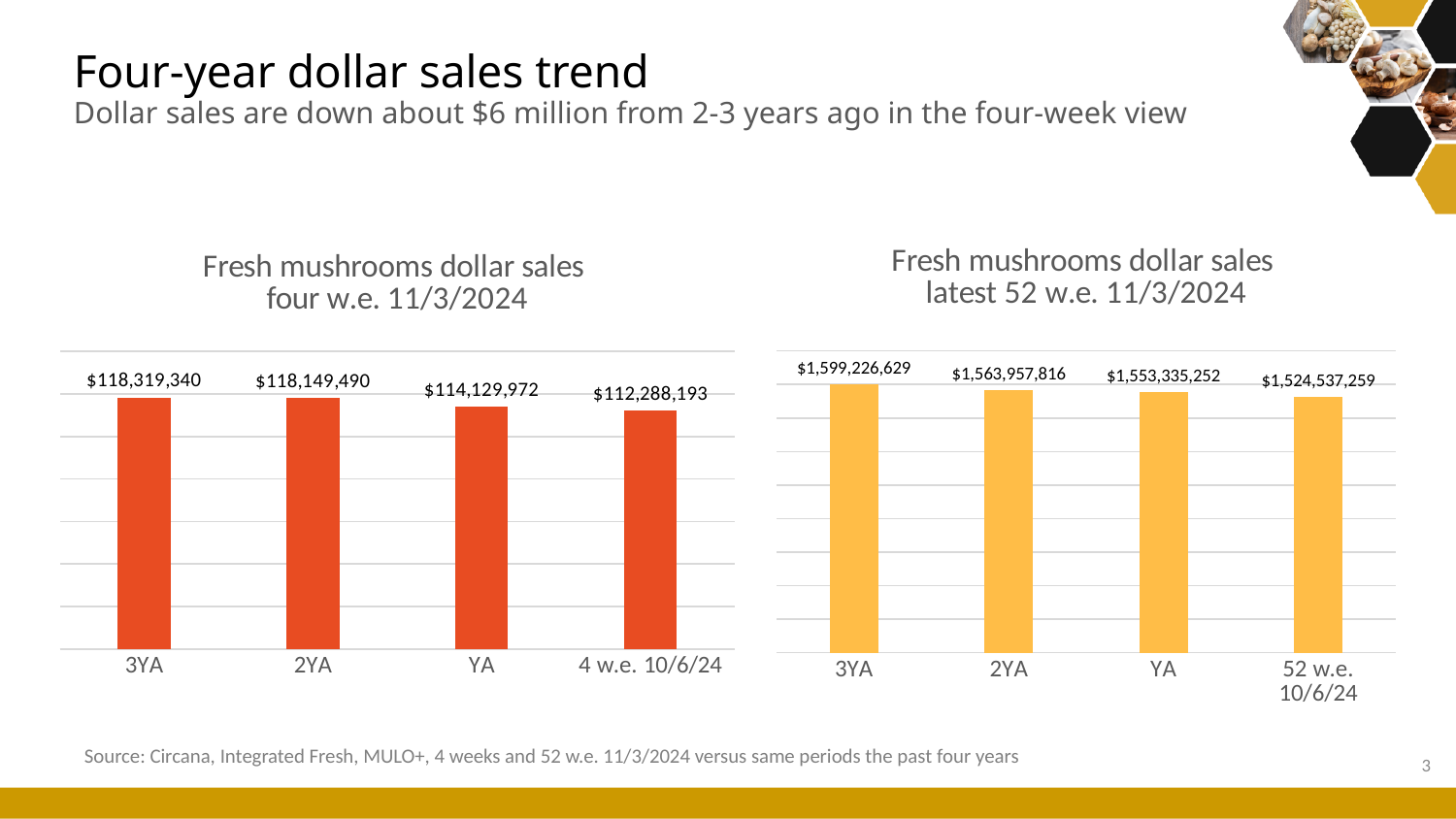
In the 'Fresh mushrooms dollar sales four w.e. 11/3/2024' chart, which category has the lowest value? 4 w.e. 10/6/24 How many categories are shown in the 'Fresh mushrooms dollar sales latest 52 w.e. 11/3/2024' chart? 4 In the 'Fresh mushrooms dollar sales four w.e. 11/3/2024' chart, which is larger, the value for YA or the value for 4 w.e. 10/6/24? YA In the 'Fresh mushrooms dollar sales four w.e. 11/3/2024' chart, what is the value for 3YA? $118,319,340 In the 'Fresh mushrooms dollar sales latest 52 w.e. 11/3/2024' chart, what is the value for 52 w.e. 10/6/24? $1,524,537,259 In the 'Fresh mushrooms dollar sales latest 52 w.e. 11/3/2024' chart, what is the value for YA? $1,553,335,252 In the 'Fresh mushrooms dollar sales four w.e. 11/3/2024' chart, what is the value for 4 w.e. 10/6/24? $112,288,193 In the 'Fresh mushrooms dollar sales latest 52 w.e. 11/3/2024' chart, which category has the highest value? 3YA What kind of chart is the 'Fresh mushrooms dollar sales four w.e. 11/3/2024' chart? Bar chart In the 'Fresh mushrooms dollar sales four w.e. 11/3/2024' chart, what is the difference between the 3YA value and the 4 w.e. 10/6/24 value? $6,031,147 In the 'Fresh mushrooms dollar sales latest 52 w.e. 11/3/2024' chart, do the values rise or fall from 3YA to 52 w.e. 10/6/24? Fall In the 'Fresh mushrooms dollar sales latest 52 w.e. 11/3/2024' chart, what is the difference between the 3YA value and the 52 w.e. 10/6/24 value? $74,689,370